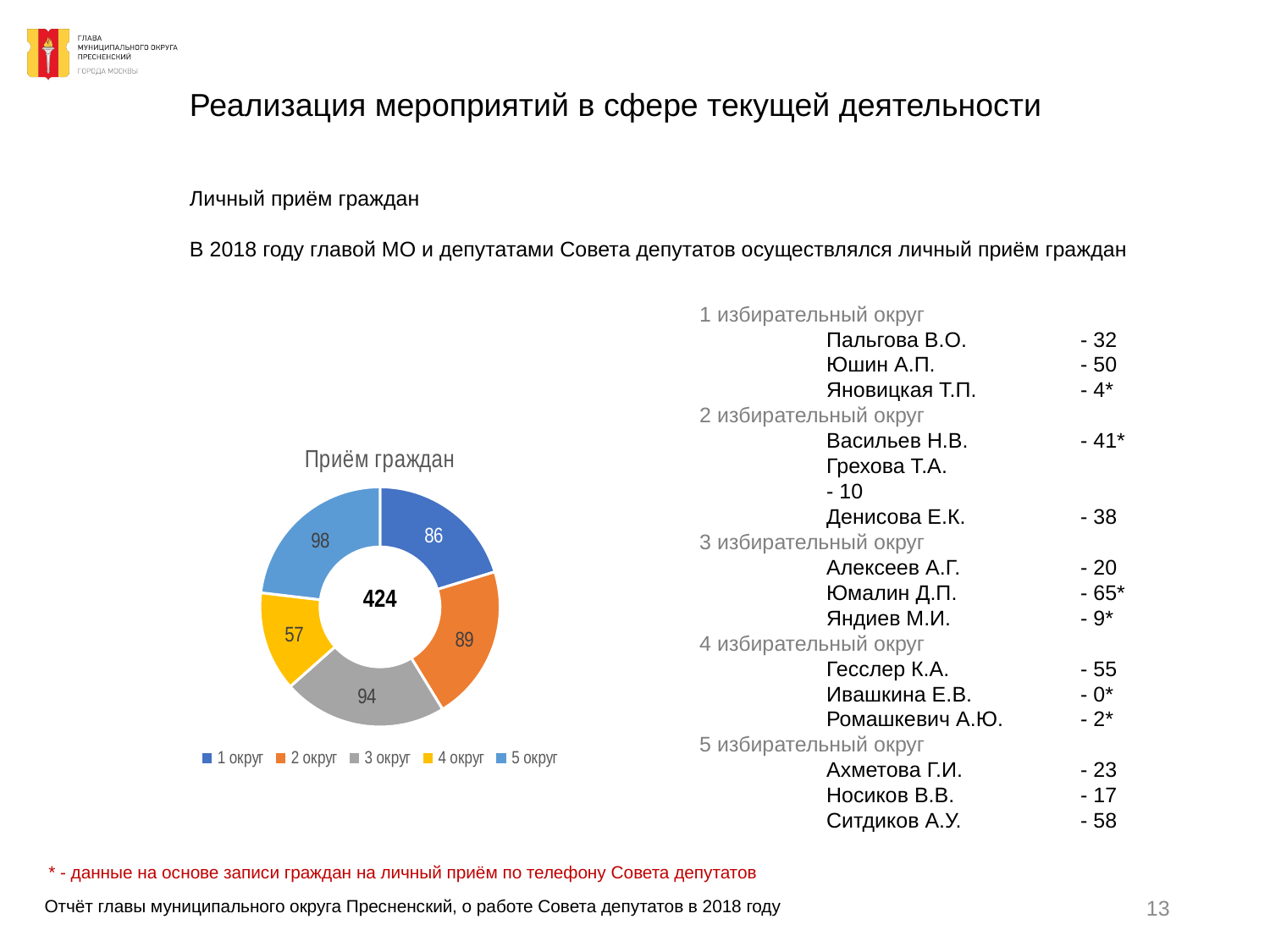
Which category has the lowest value in the Приём граждан chart? 4 округ Which category has the highest value in the Приём граждан chart? 5 округ Which is larger in the Приём граждан chart, the value for 2 округ or 3 округ? 3 округ What is the value for 1 округ in the Приём граждан chart? 86 What is the title of the chart on the slide? Приём граждан What kind of chart is the Приём граждан chart? doughnut (pie) chart How many categories are shown in the Приём граждан chart? 5 What is the total shown in the centre of the Приём граждан chart? 424 What is the difference between the values for 5 округ and 4 округ in the Приём граждан chart? 41 What is the value for 4 округ in the Приём граждан chart? 57 What is the value for 3 округ in the Приём граждан chart? 94 How many entries does the legend of the Приём граждан chart list? 5